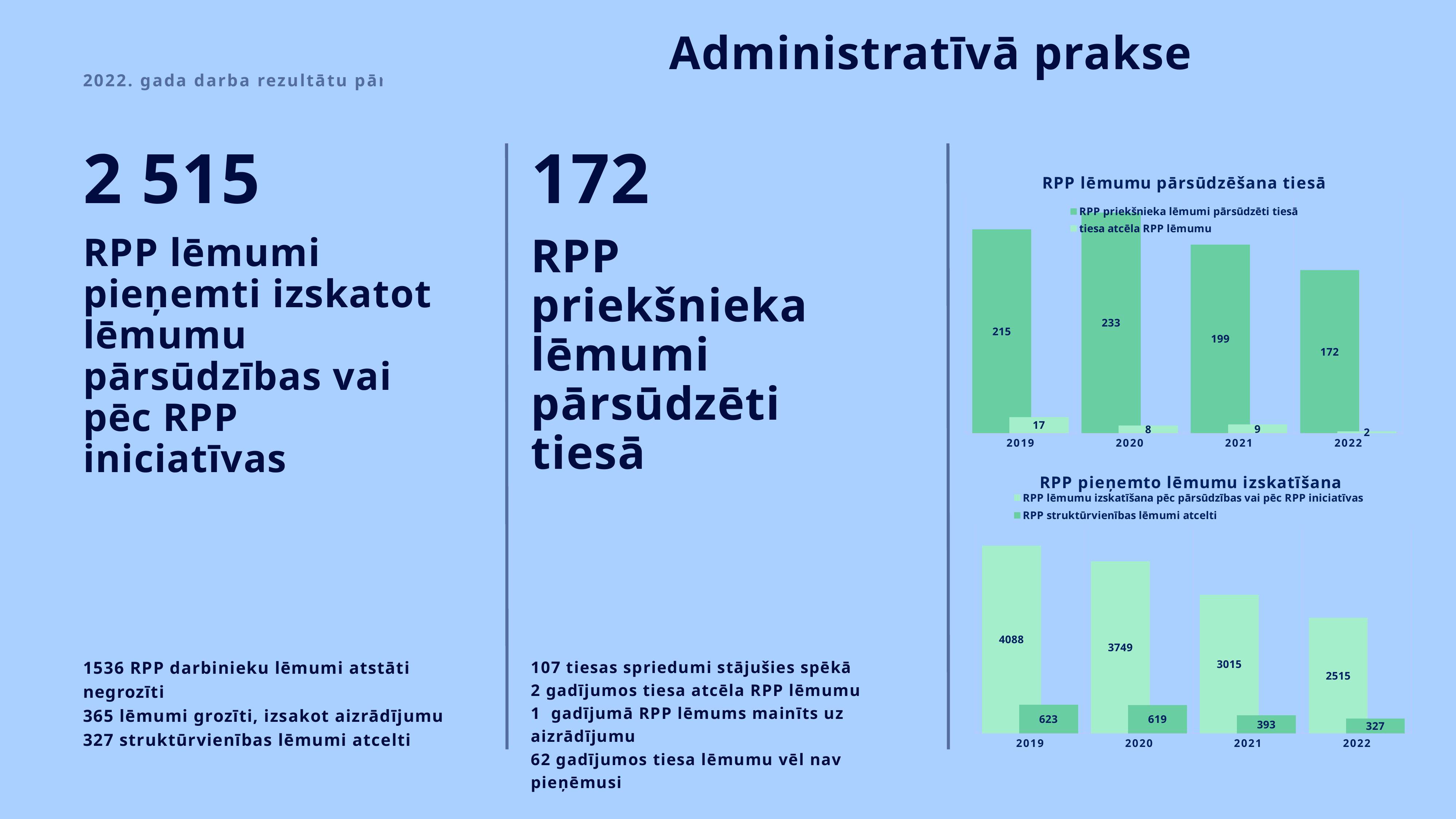
In the chart 'RPP lēmumu pārsūdzēšana tiesā', what is the difference between the 'RPP priekšnieka lēmumi pārsūdzēti tiesā' values for 2020 and 2022? 61 In the chart 'RPP lēmumu pārsūdzēšana tiesā', what is the value for 'tiesa atcēla RPP lēmumu' in 2019? 17 In the chart 'RPP pieņemto lēmumu izskatīšana', what is the value for 'RPP lēmumu izskatīšana pēc pārsūdzības vai pēc RPP iniciatīvas' in 2021? 3015 What kind of chart is 'RPP pieņemto lēmumu izskatīšana'? Bar chart In the chart 'RPP lēmumu pārsūdzēšana tiesā', what is the value for 'RPP priekšnieka lēmumi pārsūdzēti tiesā' in 2020? 233 In the chart 'RPP pieņemto lēmumu izskatīšana', what is the difference between the 'RPP struktūrvienības lēmumi atcelti' values for 2019 and 2020? 4 In the chart 'RPP lēmumu pārsūdzēšana tiesā', how many series does the legend list? 2 In the chart 'RPP lēmumu pārsūdzēšana tiesā', how many years are shown on the x axis? 4 In the chart 'RPP pieņemto lēmumu izskatīšana', which year has the highest value for 'RPP lēmumu izskatīšana pēc pārsūdzības vai pēc RPP iniciatīvas'? 2019 In the chart 'RPP pieņemto lēmumu izskatīšana', how does the value for 'RPP lēmumu izskatīšana pēc pārsūdzības vai pēc RPP iniciatīvas' change from 2019 to 2022? It falls In the chart 'RPP pieņemto lēmumu izskatīšana', what is the value for 'RPP struktūrvienības lēmumi atcelti' in 2022? 327 In the chart 'RPP lēmumu pārsūdzēšana tiesā', which year has the lowest value for 'RPP priekšnieka lēmumi pārsūdzēti tiesā'? 2022